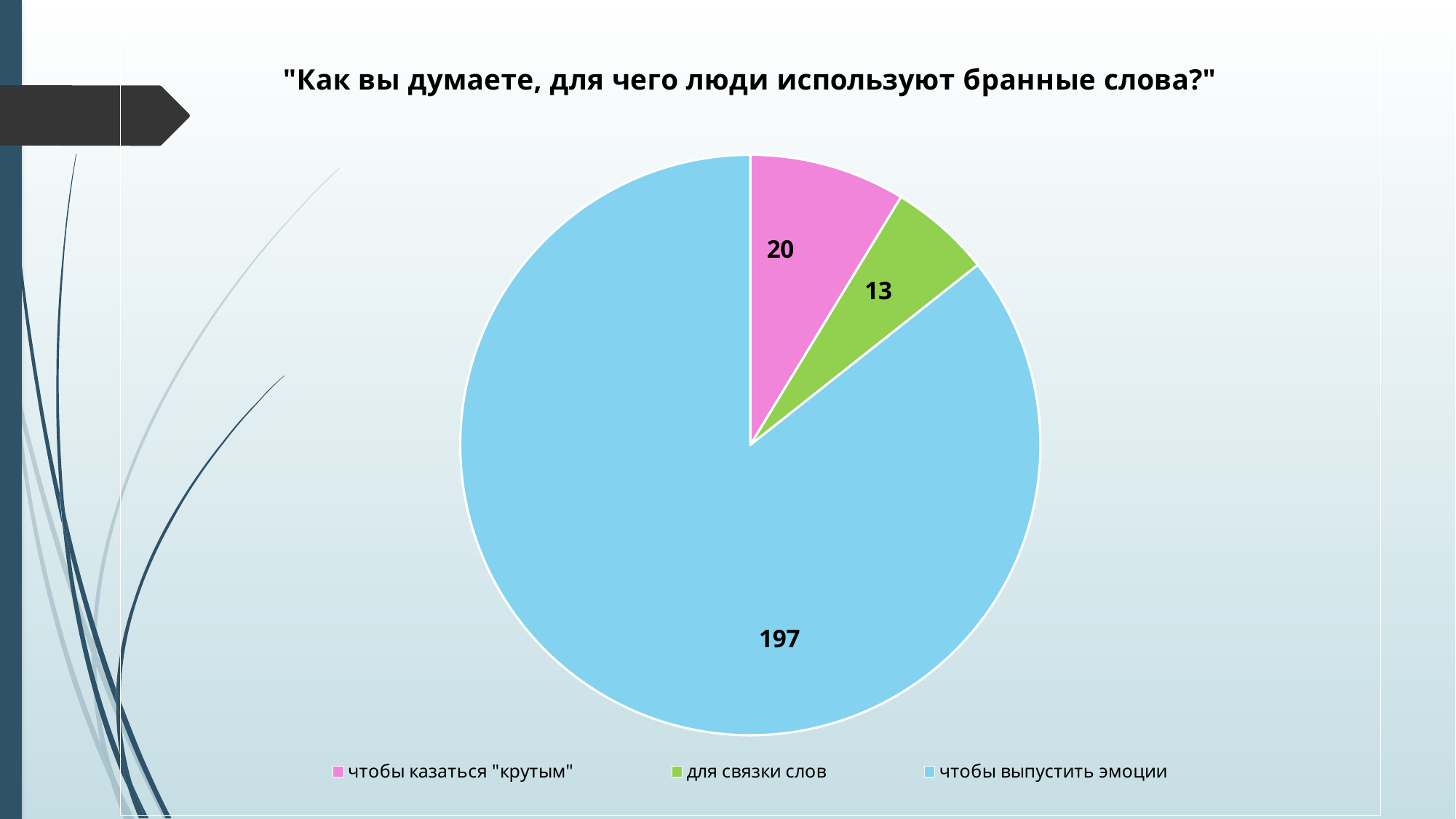
What is the difference between the values for "чтобы выпустить эмоции" and "чтобы казаться "крутым""? 177 What is the total of all the values shown in the pie chart? 230 What colour is the slice for "для связки слов"? green What value is shown for the slice "чтобы казаться "крутым""? 20 Which is larger: the value for "чтобы казаться "крутым"" or the value for "для связки слов"? чтобы казаться "крутым" What value is shown for the slice "для связки слов"? 13 Which category has the largest slice of the pie? чтобы выпустить эмоции How many slices does the pie chart have? 3 Which category has the smallest slice of the pie? для связки слов What value is shown for the slice "чтобы выпустить эмоции"? 197 What is the difference between the values for "чтобы казаться "крутым"" and "для связки слов"? 7 What type of chart is shown on the slide? pie chart